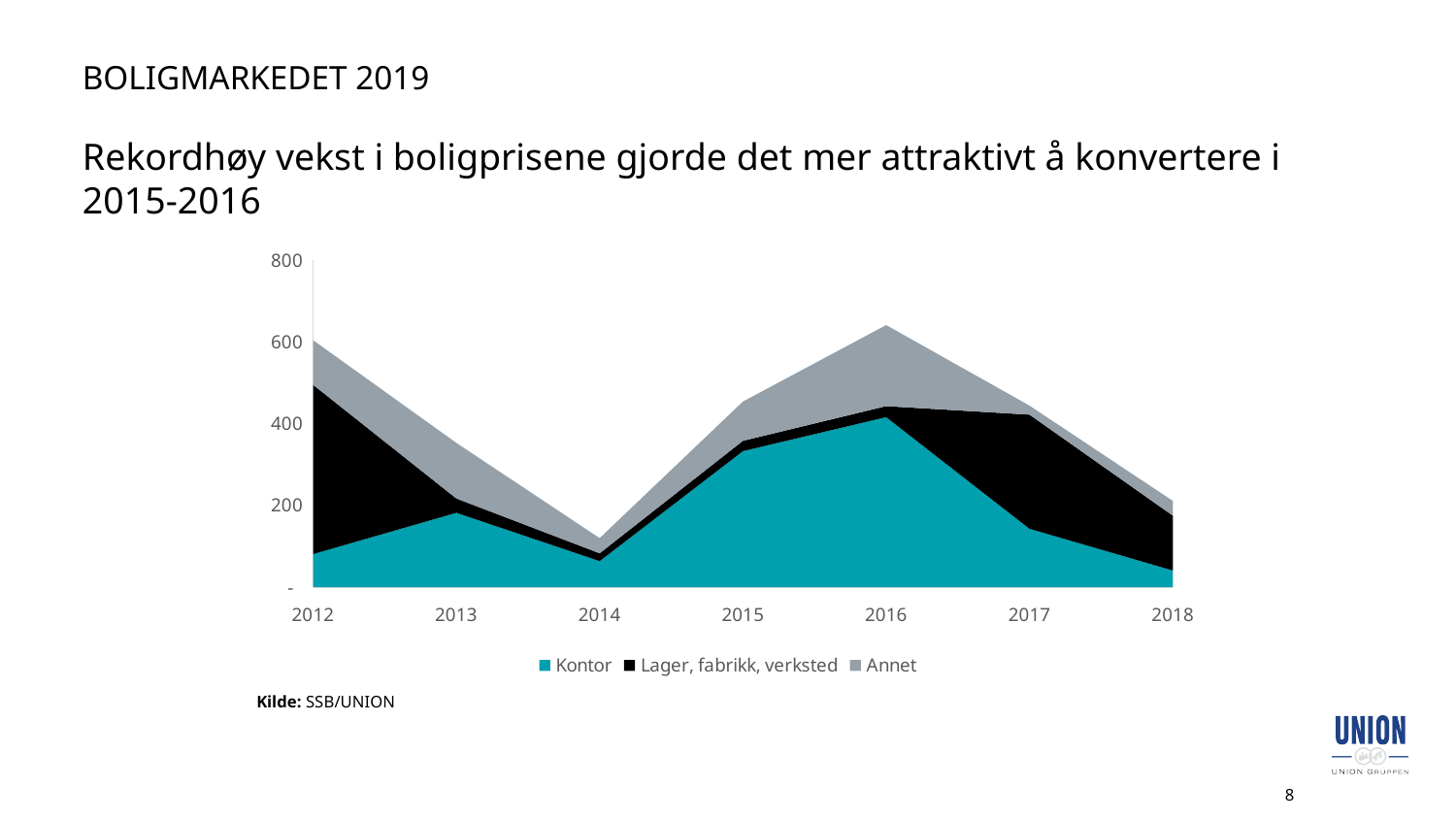
What kind of chart is shown on the slide? Stacked area chart In which year is the total stacked value lowest? 2014 Is the total stacked value for 2014 greater or less than 200? less What are the three series named in the chart's legend? Kontor; Lager, fabrikk, verksted; Annet Which year has the larger total stacked value, 2012 or 2013? 2012 How many years are shown on the x axis of the chart? 7 How many series does the chart's legend list? 3 Does the total stacked value rise or fall from 2016 to 2018? Fall Is the total stacked value for 2016 greater or less than 600? greater Is the Kontor value for 2012 greater or less than 200? less In which year is the total stacked value highest? 2016